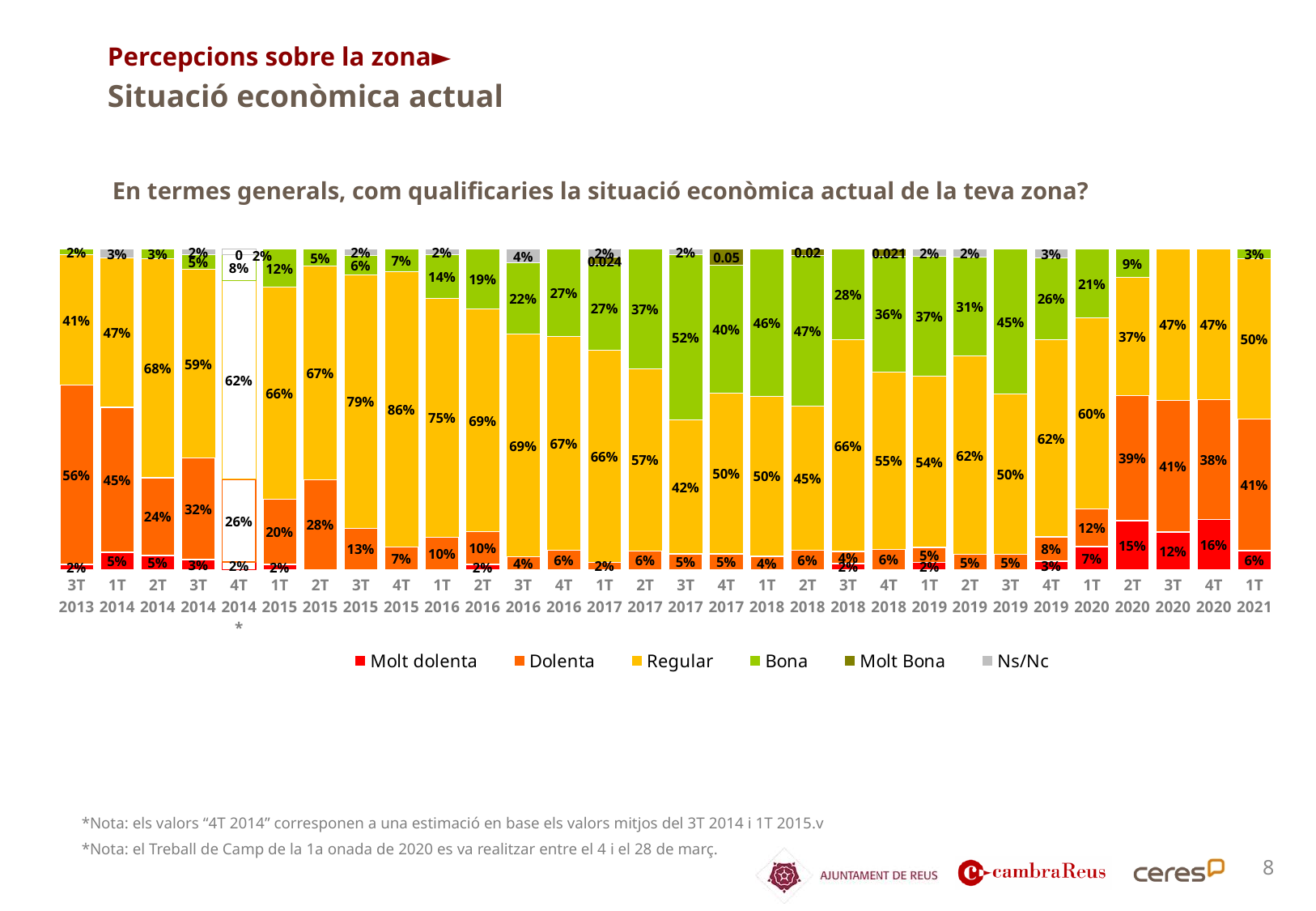
What is the "Bona" value for 3T 2017? 52% What kind of chart is shown on the slide? Stacked bar chart How many series does the legend list? 6 What percentage of respondents rated the situation as "Regular" in 4T 2015? 86% What is the difference between the "Dolenta" value in 3T 2013 and in 1T 2021? 15 percentage points In which quarter does the "Regular" series reach its highest value? 4T 2015 Which quarter on the x axis is marked with an asterisk? 4T 2014 What is the "Dolenta" value for 3T 2013? 56% In which quarter is the "Dolenta" value highest? 3T 2013 What is the "Molt dolenta" value for 4T 2020? 16% How many quarters (bars) are shown on the chart? 30 In 3T 2020, which is larger: the "Bona" value or the "Regular" value? Regular